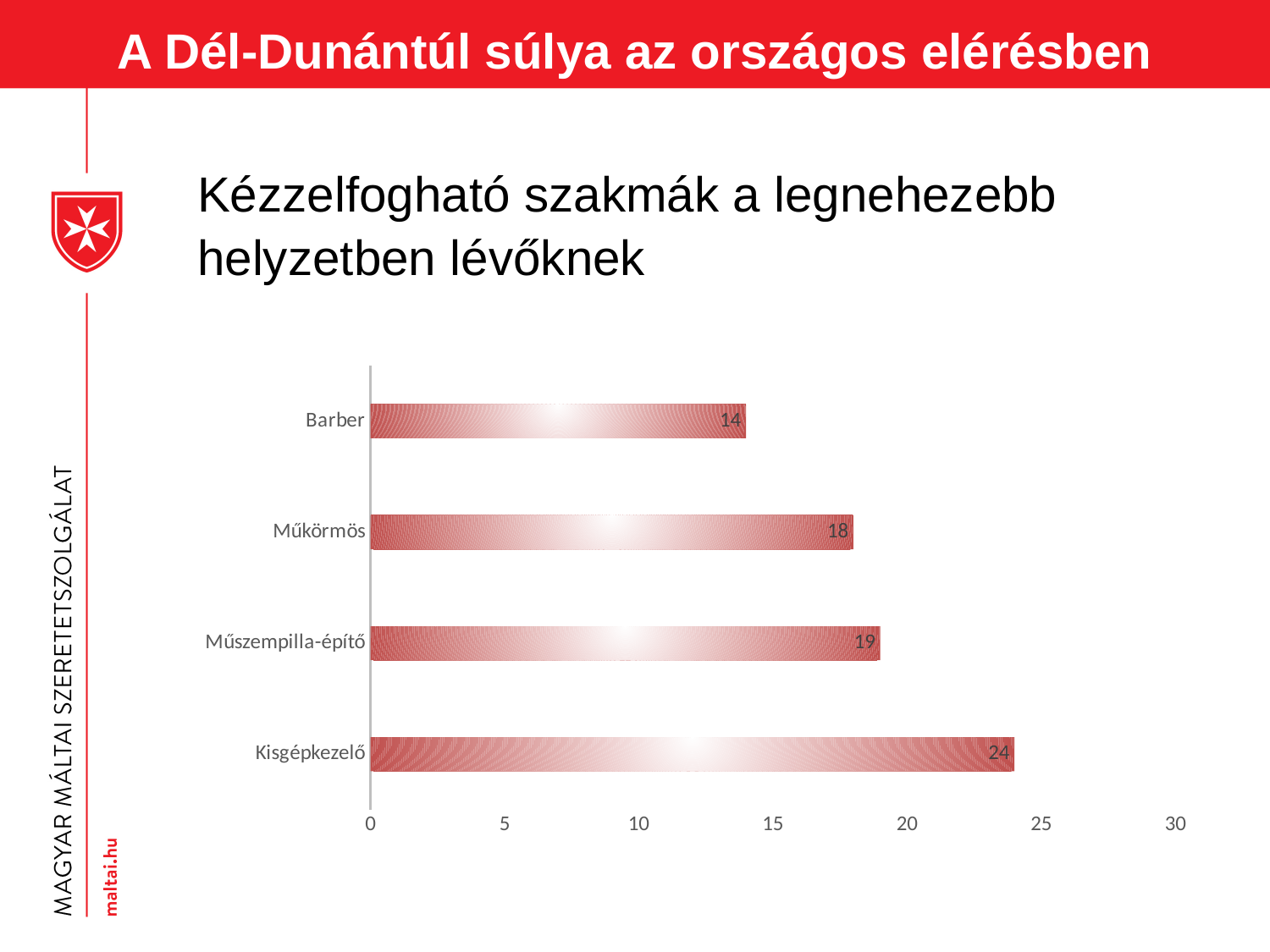
Which is larger, the value for Műkörmös or the value for Barber? Műkörmös What is the value for Barber? 14 Which category has the lowest value? Barber What is the value for Kisgépkezelő? 24 How many categories are shown in the chart? 4 What is the difference between the values for Műszempilla-építő and Műkörmös? 1 What kind of chart is shown on the slide? Bar chart Is the value for Kisgépkezelő greater or less than 20? greater What is the difference between the values for Kisgépkezelő and Barber? 10 What is the value for Műkörmös? 18 Which category has the highest value? Kisgépkezelő What is the value for Műszempilla-építő? 19